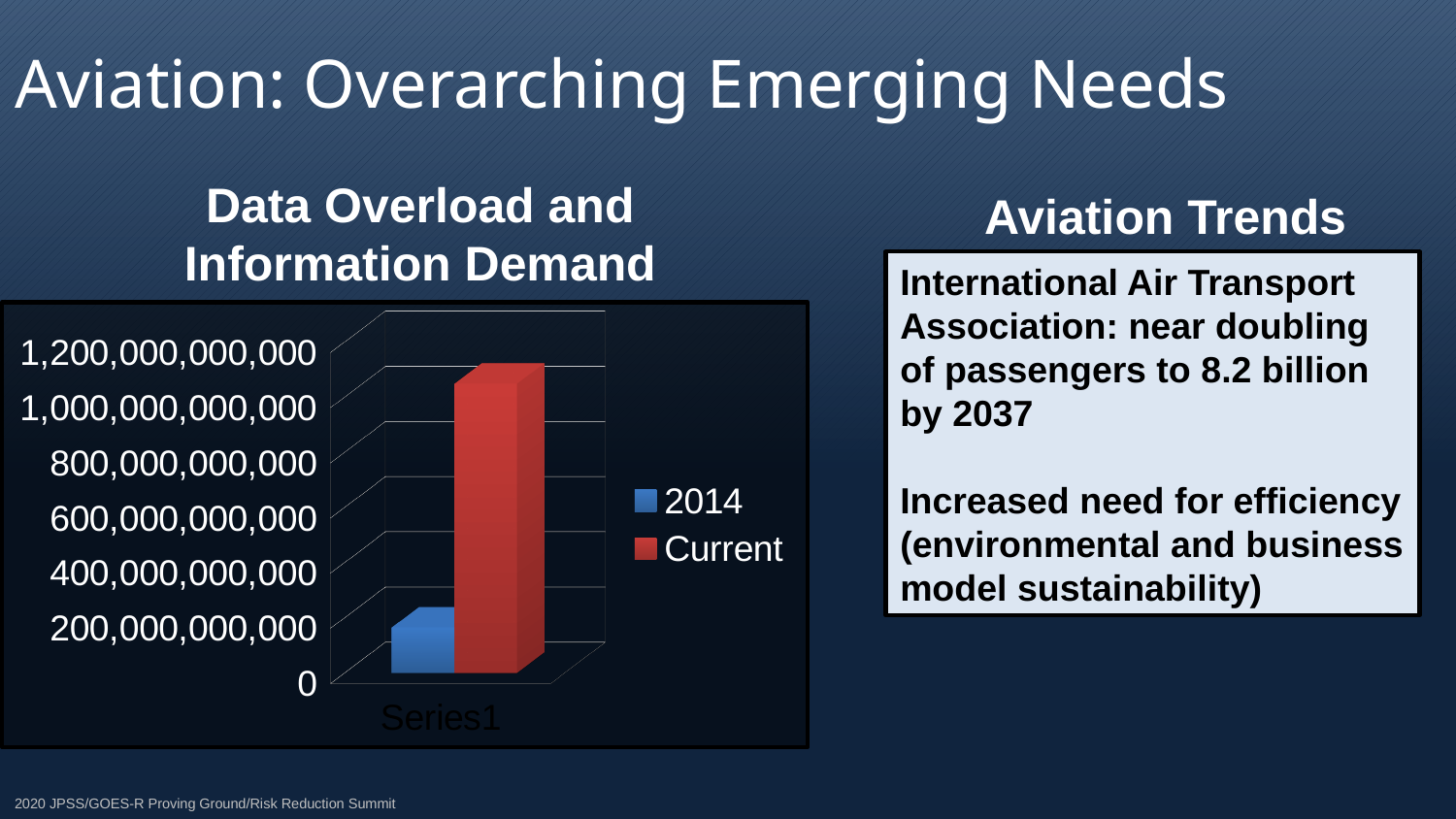
What kind of chart is shown on the slide? bar chart Is the value for Current greater or less than 800,000,000,000? greater Which series has the highest value in the chart? Current What are the two series named in the chart legend? 2014 and Current What is the title of the chart? Data Overload and Information Demand Is the value for 2014 greater or less than 400,000,000,000? less Which series has the lowest value in the chart? 2014 Which series has the higher value, 2014 or Current? Current How many series does the chart legend list? 2 How many categories are shown on the x axis of the chart? 1 Is the value for 2014 greater or less than 600,000,000,000? less